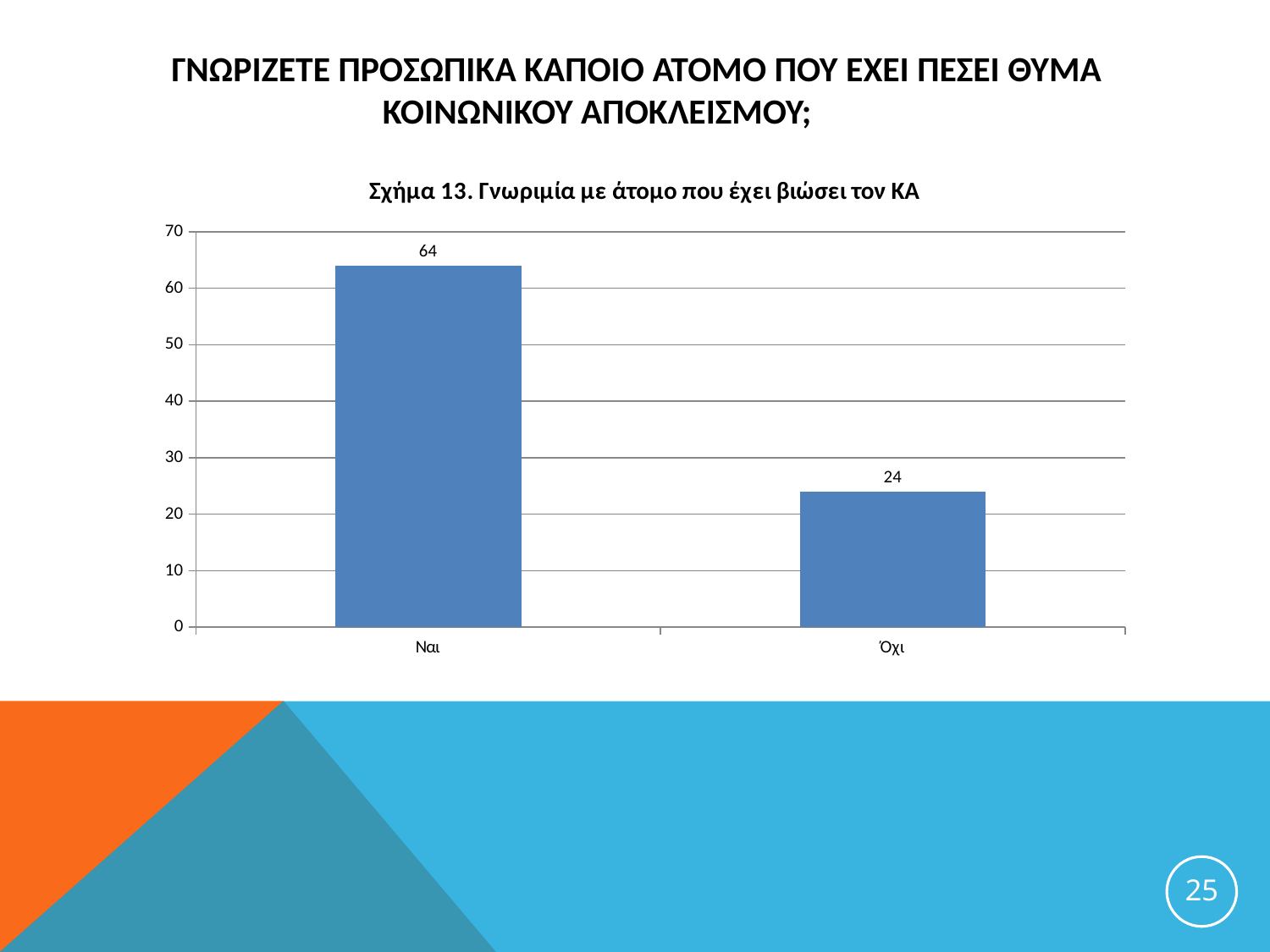
How many categories are shown on the x axis? 2 Is the value for Όχι greater or less than 30? less What is the value for Όχι? 24 What is the value for Ναι? 64 What is the highest value shown on the y axis? 70 What is the title of the chart? Σχήμα 13. Γνωριμία με άτομο που έχει βιώσει τον ΚΑ What kind of chart is shown on the slide? bar chart What is the difference between the values for Ναι and Όχι? 40 Which category has the lowest value? Όχι Which category has the highest value? Ναι Which is larger, the value for Ναι or the value for Όχι? Ναι Is the value for Ναι greater or less than 60? greater